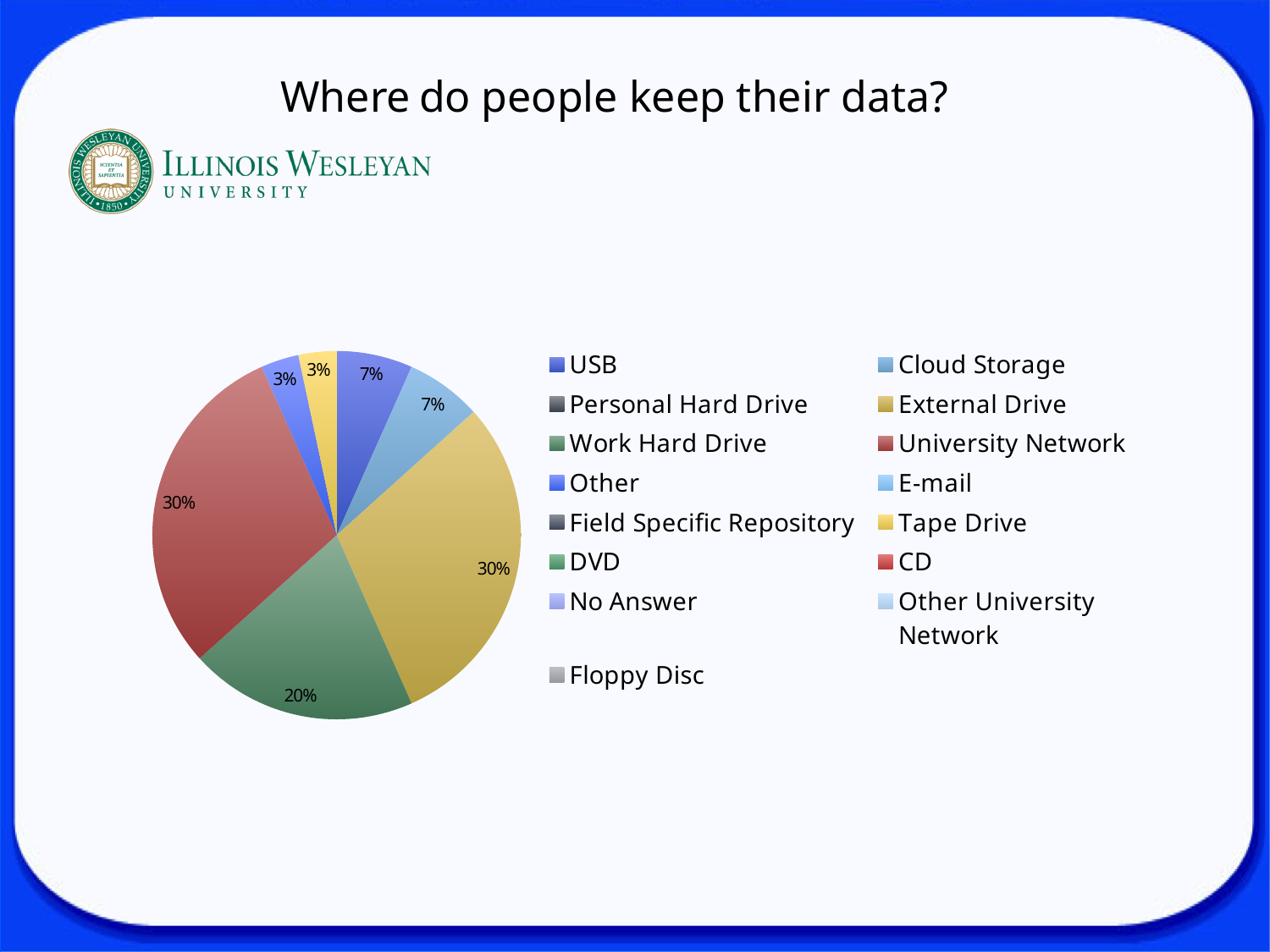
How many slices of the pie have a percentage label? 7 What share of the pie does University Network represent? 30% What is the difference between the share for University Network and the share for Work Hard Drive? 10% What share of the pie does Cloud Storage represent? 7% How many entries does the legend list? 15 What share of the pie does Tape Drive represent? 3% Which is larger, the share for External Drive or the share for Work Hard Drive? External Drive What share of the pie does External Drive represent? 30% What share of the pie does Work Hard Drive represent? 20% What share of the pie does USB represent? 7% What kind of chart is shown on the slide? pie chart What is the title of the slide's chart? Where do people keep their data?